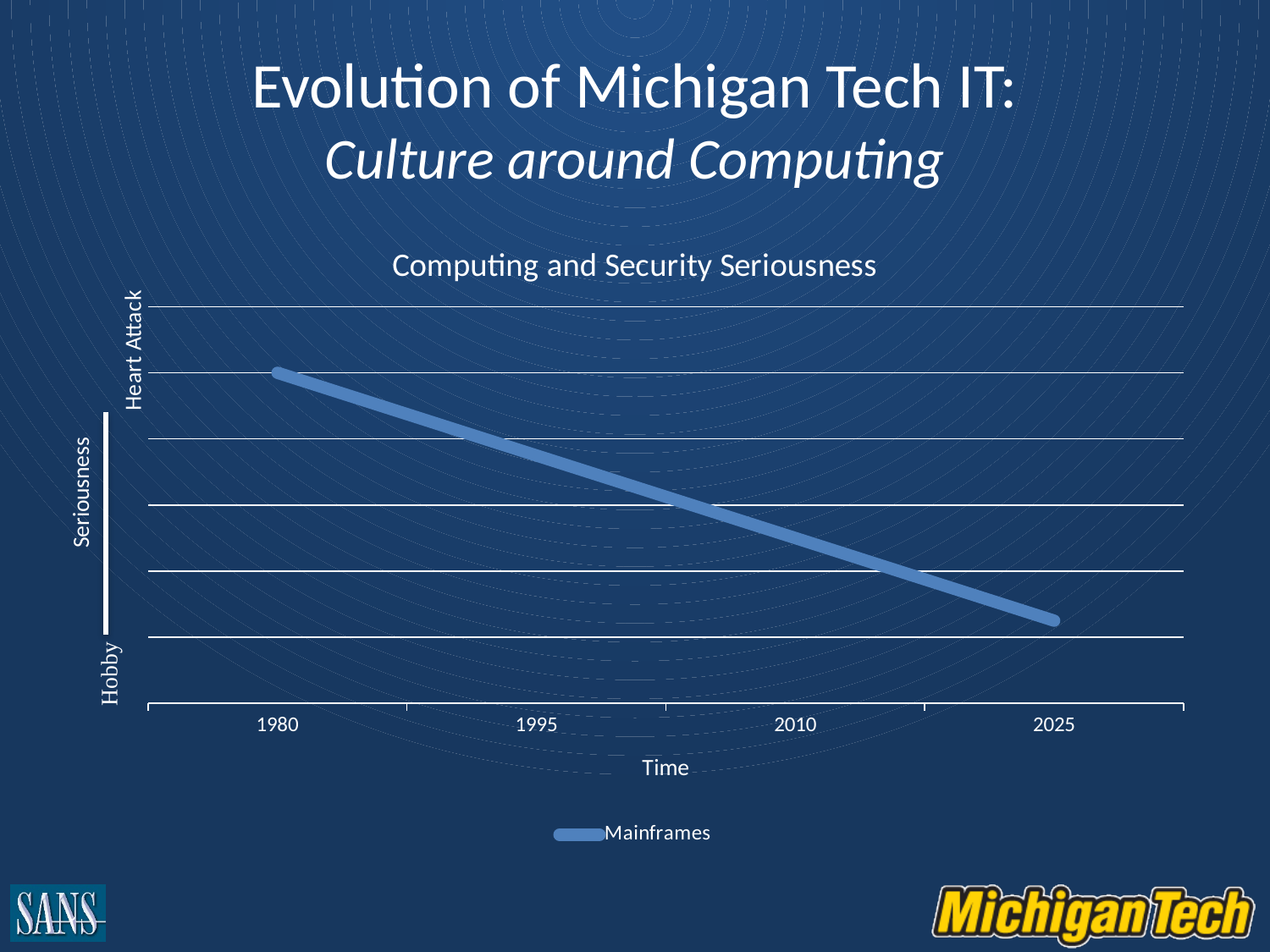
What is the title of the chart? Computing and Security Seriousness At which labelled year is the Mainframes line highest? 1980 What series is listed in the chart legend? Mainframes Is the Mainframes value higher in 1995 or in 2010? 1995 What is the label of the x axis? Time Does the Mainframes line rise or fall from 1980 to 2025? Fall How many year labels are shown on the x axis? 4 What kind of chart is shown on the slide? Line chart Is the Mainframes value higher in 1980 or in 2025? 1980 At which labelled year is the Mainframes line lowest? 2025 How many series does the chart legend list? 1